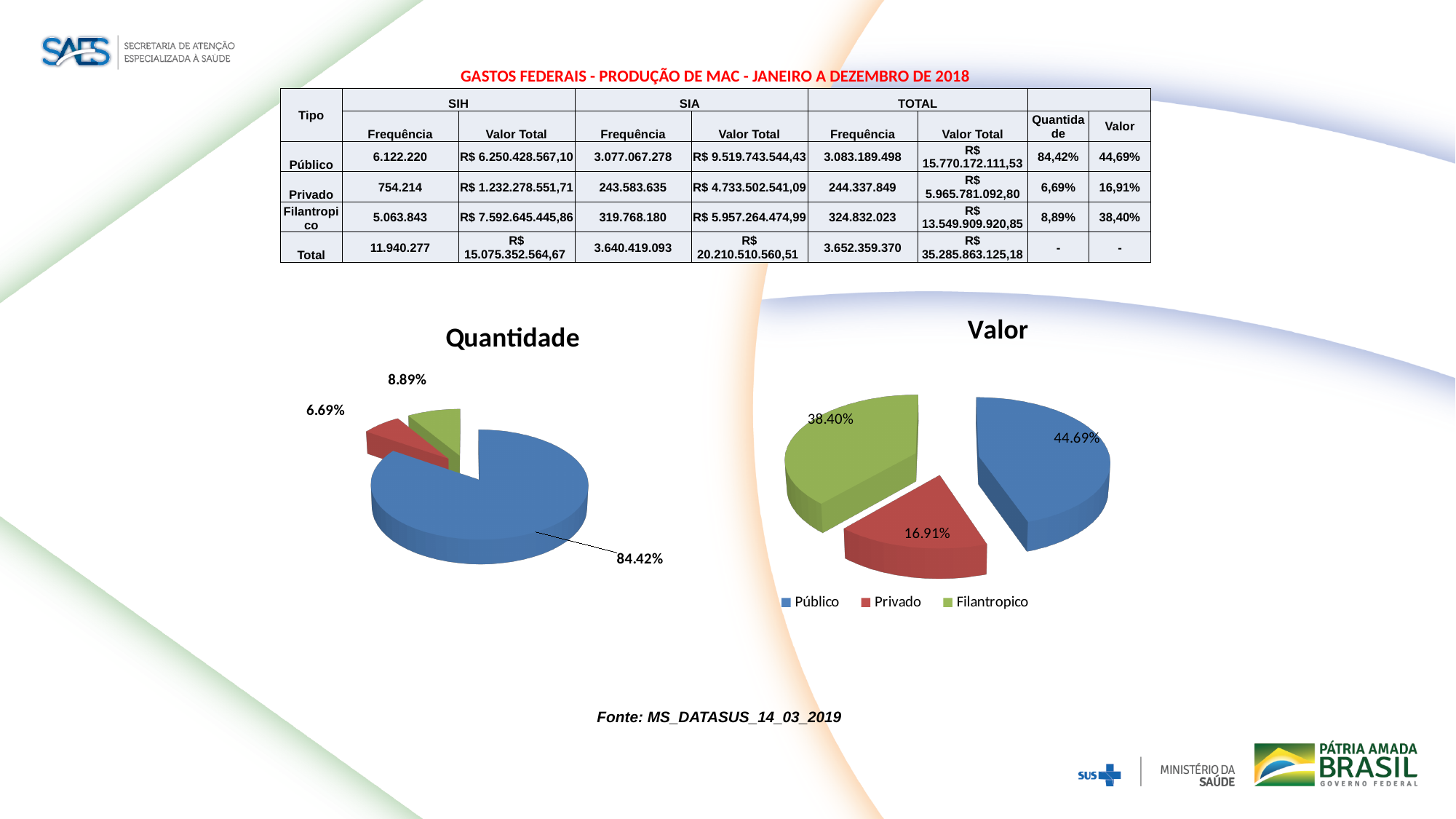
In the "Quantidade" chart, what is the share of the green slice? 8.89% In the "Valor" chart, which category has the largest share? Público In the "Quantidade" chart, what is the share of the red slice? 6.69% In the "Valor" chart, which category has the smallest share? Privado In the "Valor" chart, what share does Filantropico have? 38.40% In the "Valor" chart, what share does Privado have? 16.91% How many entries does the legend of the "Valor" chart list? 3 In the "Valor" chart, what is the difference between the Público and Filantropico shares? 6.29% What kind of chart is the "Quantidade" chart? pie chart How many slices does the "Quantidade" pie chart have? 3 In the "Valor" chart, what share does Público have? 44.69% In the "Quantidade" chart, what is the share of the largest (blue) slice? 84.42%